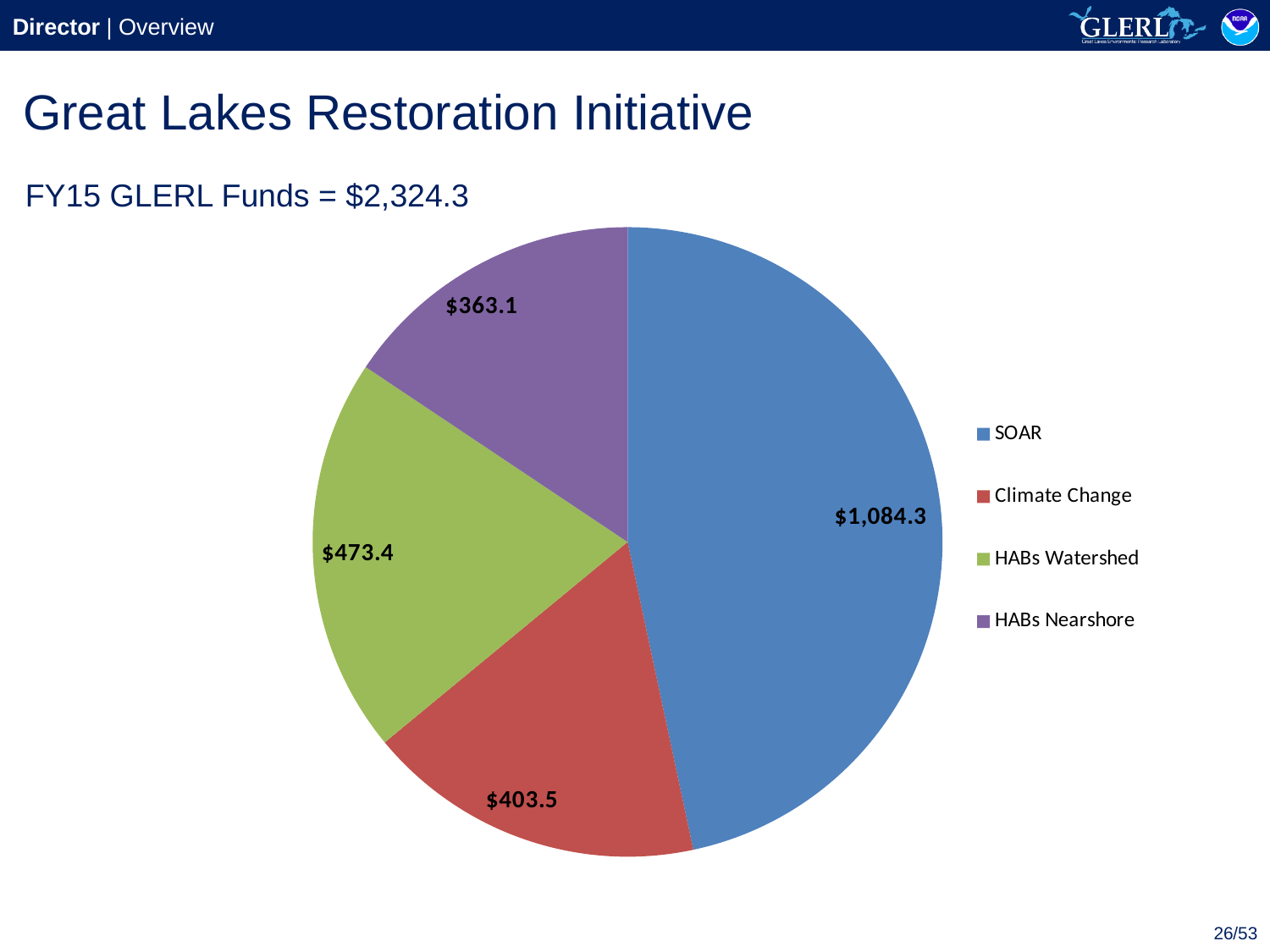
What is the value for Climate Change? $403.5 What is the value for SOAR? $1,084.3 What is the difference between the HABs Watershed value and the HABs Nearshore value? $110.3 What type of chart is shown on the slide? Pie chart How many categories does the legend list? 4 Which is larger, HABs Watershed or Climate Change? HABs Watershed What is the value for HABs Watershed? $473.4 Which category has the largest slice of the pie? SOAR What is the value for HABs Nearshore? $363.1 What is the difference between the SOAR value and the Climate Change value? $680.8 What total FY15 GLERL funds amount is stated above the chart? $2,324.3 Which category has the smallest slice of the pie? HABs Nearshore